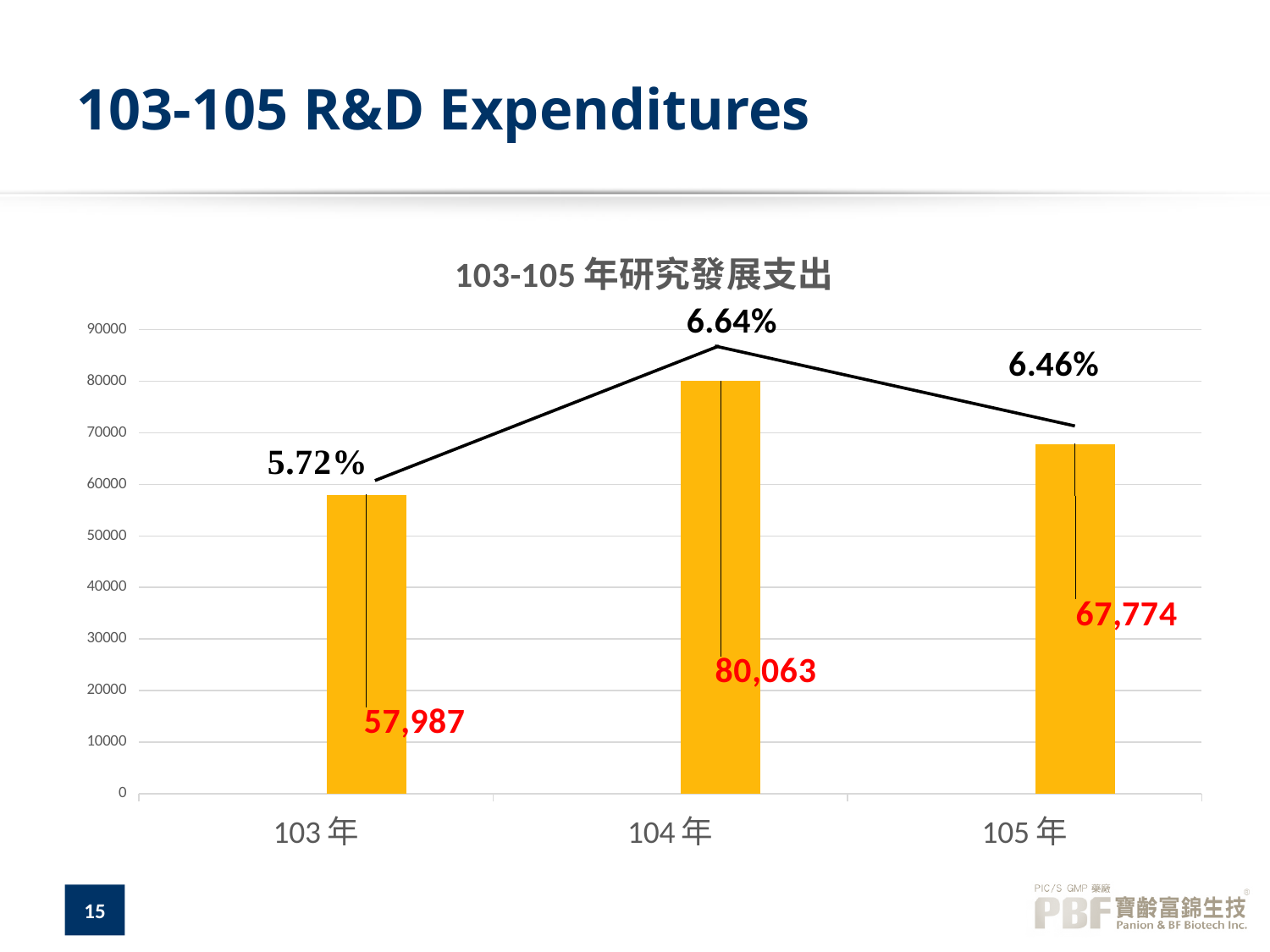
Which is larger, the R&D expenditure for 105 年 or for 103 年? 105 年 What is the R&D expenditure value shown for 105 年? 67,774 What kind of chart is used to show the R&D expenditure values? Bar chart What percentage is labelled for 103 年? 5.72% Which year has the lowest R&D expenditure? 103 年 What percentage is labelled above the bar for 104 年? 6.64% What is the difference between the R&D expenditure for 104 年 and 103 年? 22,076 Which year has the highest R&D expenditure? 104 年 What is the R&D expenditure value shown for 104 年? 80,063 How many years (categories) are shown on the x axis? 3 What is the title of the chart? 103-105 年研究發展支出 What is the R&D expenditure value shown for 103 年? 57,987